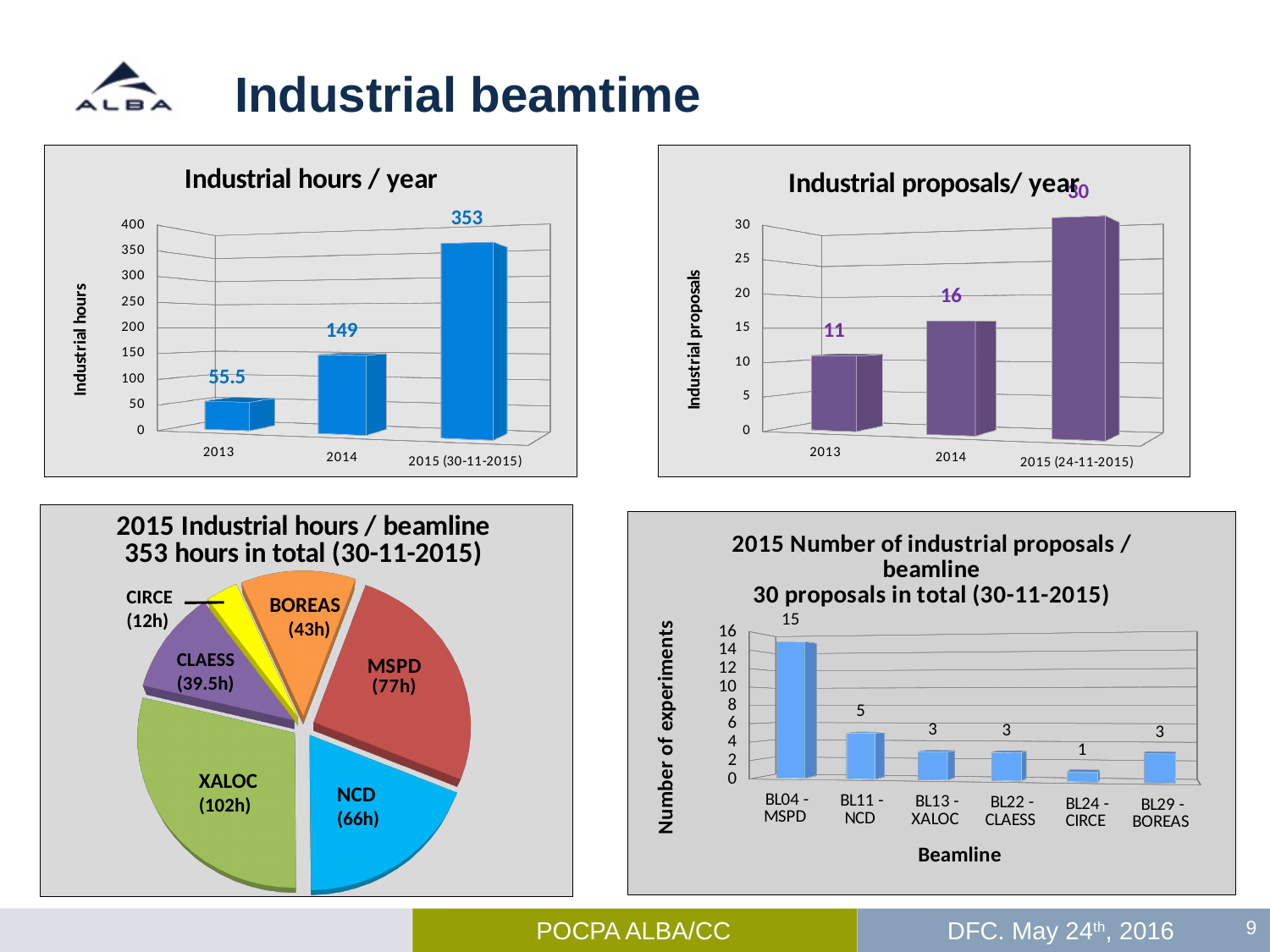
In the 'Industrial hours / year' chart, what is the value for 2014? 149 In the 'Industrial proposals/ year' chart, what is the value for 2013? 11 In the '2015 Industrial hours / beamline' pie chart, how many beamlines are shown? 6 In the 'Industrial proposals/ year' chart, which year has the highest value? 2015 (24-11-2015) In the 'Industrial proposals/ year' chart, do the values rise or fall from 2013 to 2015? rise In the '2015 Industrial hours / beamline' pie chart, which is larger, MSPD or NCD? MSPD In the '2015 Number of industrial proposals / beamline' chart, which beamline has the lowest value? BL24 - CIRCE In the '2015 Industrial hours / beamline' pie chart, how many hours does XALOC have? 102h In the 'Industrial hours / year' chart, what is the difference between the 2015 and 2013 values? 297.5 In the '2015 Number of industrial proposals / beamline' chart, what is the value for BL11 - NCD? 5 What type of chart is the '2015 Number of industrial proposals / beamline' chart? bar chart In the '2015 Industrial hours / beamline' pie chart, which beamline has the smallest slice? CIRCE